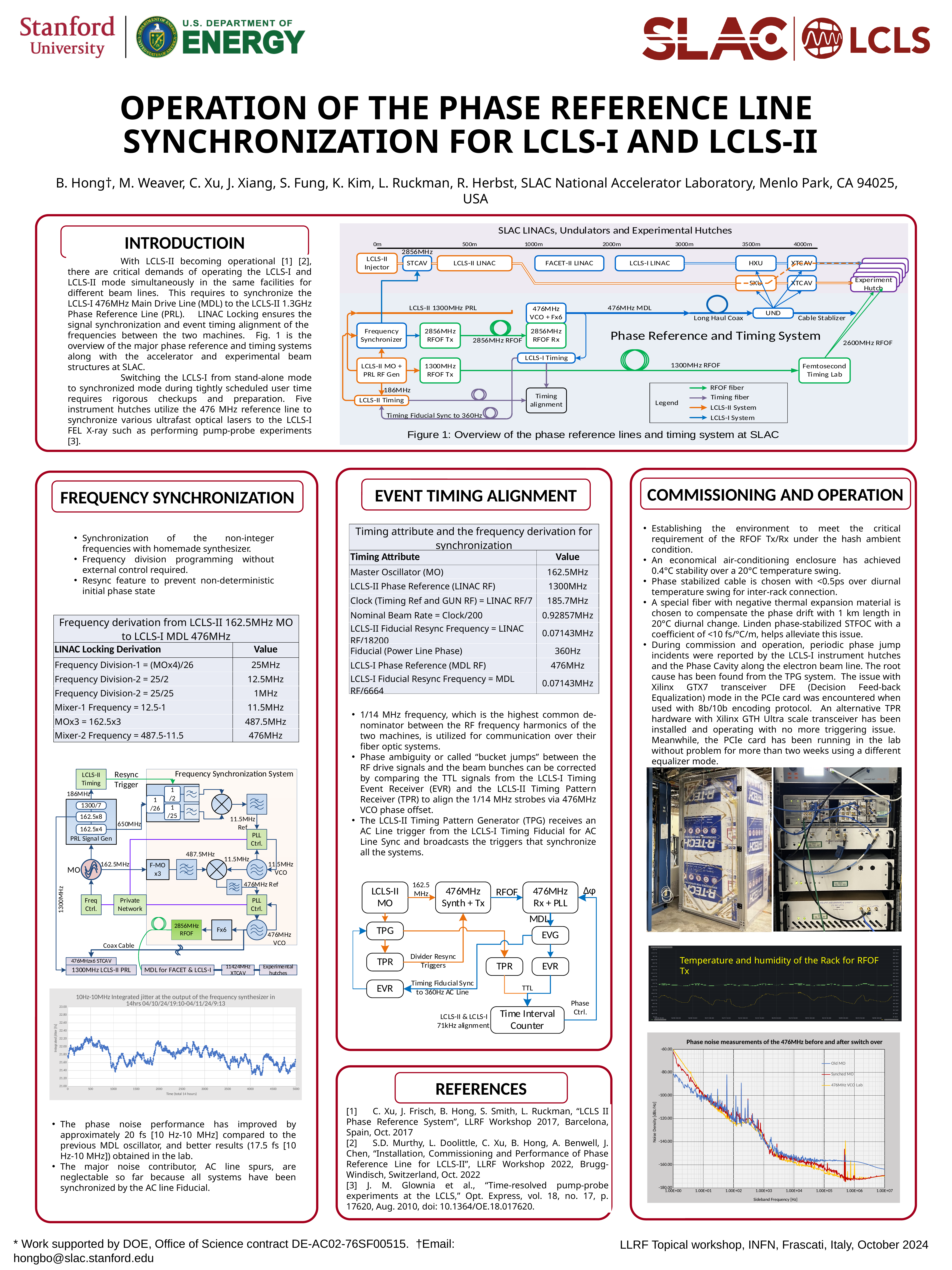
What kind of chart is the 'Phase noise measurements of the 476MHz before and after switch over' chart at the bottom right? line chart What are the legend entries in the 'Phase noise measurements of the 476MHz before and after switch over' chart? Old MO, Synched MO, 476MHz VCO Lab In the '10Hz-10MHz Integrated jitter' chart, is the integrated jitter at time 0 greater or less than 23.00? less In the 'Phase noise measurements of the 476MHz before and after switch over' chart, is the noise density at 1.00E+05 Hz greater or less than -140? less In the 'Phase noise measurements of the 476MHz before and after switch over' chart, do the noise density values rise or fall as sideband frequency increases along the x axis? fall What is the title of the chart shown in the right column between the equipment photos and the phase noise chart? Temperature and humidity of the Rack for RFOF Tx In the 'Phase noise measurements of the 476MHz before and after switch over' chart, is the noise density at 1.00E+03 Hz greater or less than -100? less How many series does the legend list in the 'Phase noise measurements of the 476MHz before and after switch over' chart? 3 What kind of chart is the '10Hz-10MHz Integrated jitter' chart at the bottom left of the poster? line chart